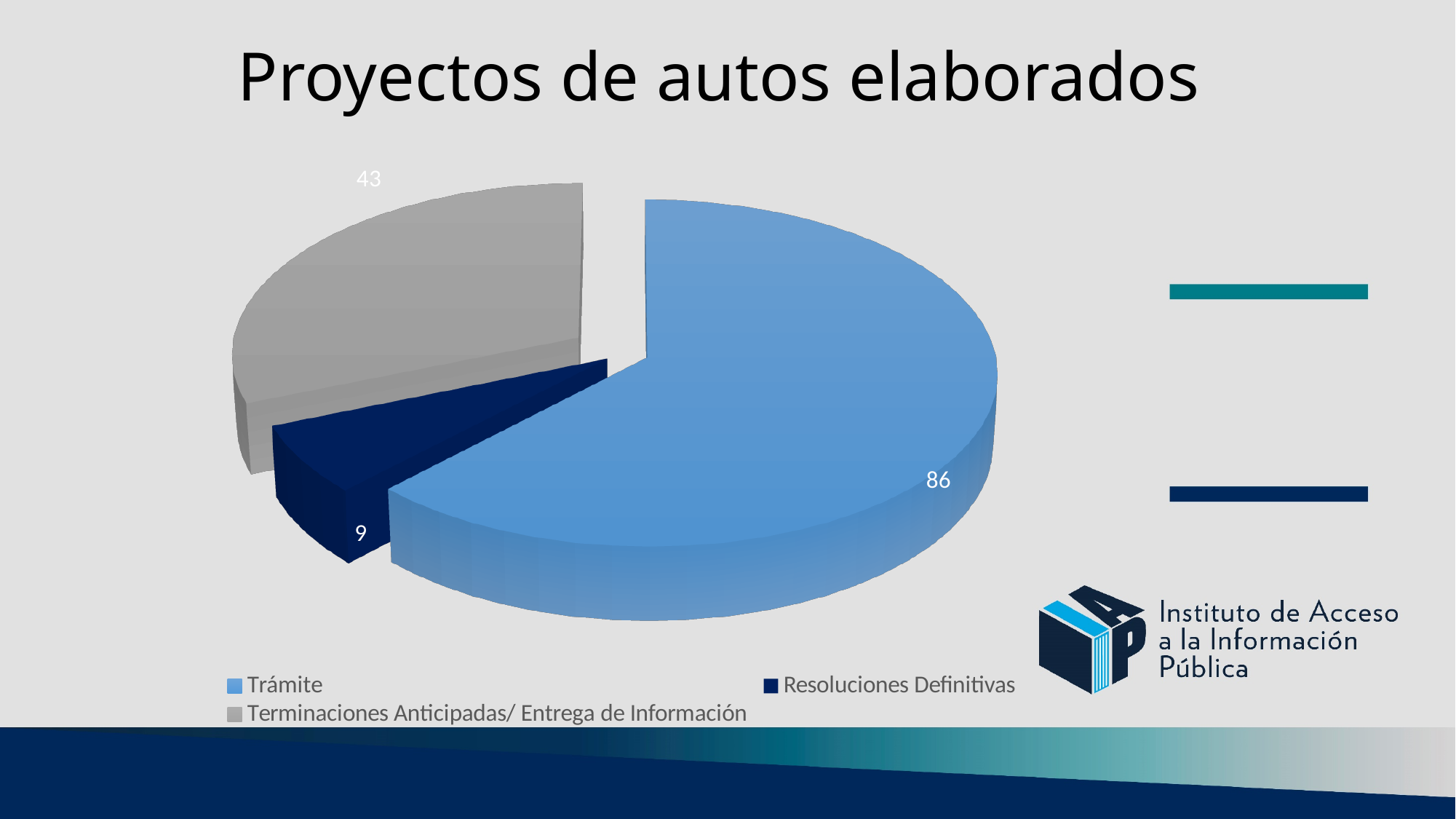
Which is larger, Terminaciones Anticipadas/ Entrega de Información or Resoluciones Definitivas? Terminaciones Anticipadas/ Entrega de Información Which category has the largest slice? Trámite What kind of chart is shown on the slide? Pie chart What is the total of all the slices in the pie chart? 138 Which category has the smallest slice? Resoluciones Definitivas How many slices does the pie chart have? 3 What is the difference between the values for Terminaciones Anticipadas/ Entrega de Información and Resoluciones Definitivas? 34 What is the value for Trámite? 86 What is the value for Resoluciones Definitivas? 9 What is the difference between the values for Trámite and Terminaciones Anticipadas/ Entrega de Información? 43 What is the title of the chart? Proyectos de autos elaborados What is the value for Terminaciones Anticipadas/ Entrega de Información? 43